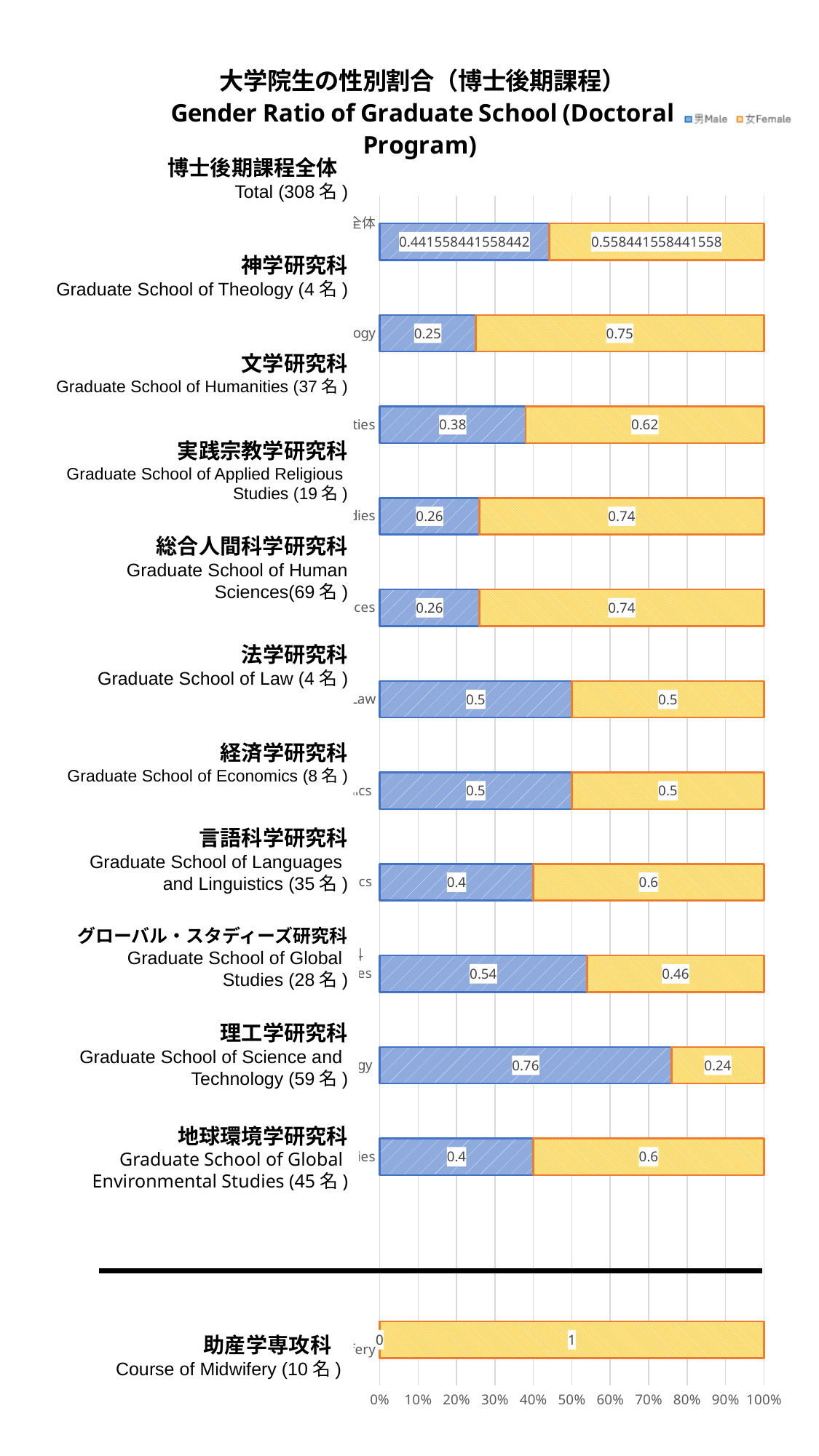
What is the difference between the Male and Female values for Graduate School of Science and Technology? 0.52 What is the Female value for Graduate School of Theology? 0.75 How many categories (bars) are shown in the chart? 12 Which has a larger Male value: Graduate School of Global Studies or Graduate School of Humanities? Graduate School of Global Studies How many series does the legend list? 2 Which category has the lowest Female value? Graduate School of Science and Technology What kind of chart is shown on the slide? Stacked bar chart What is the Female value for Graduate School of Global Studies? 0.46 Is the Male value for Graduate School of Theology greater or less than 30%? less What is the Male value for Graduate School of Science and Technology? 0.76 Which graduate school has the highest Male value? Graduate School of Science and Technology What is the Male value for Graduate School of Humanities? 0.38